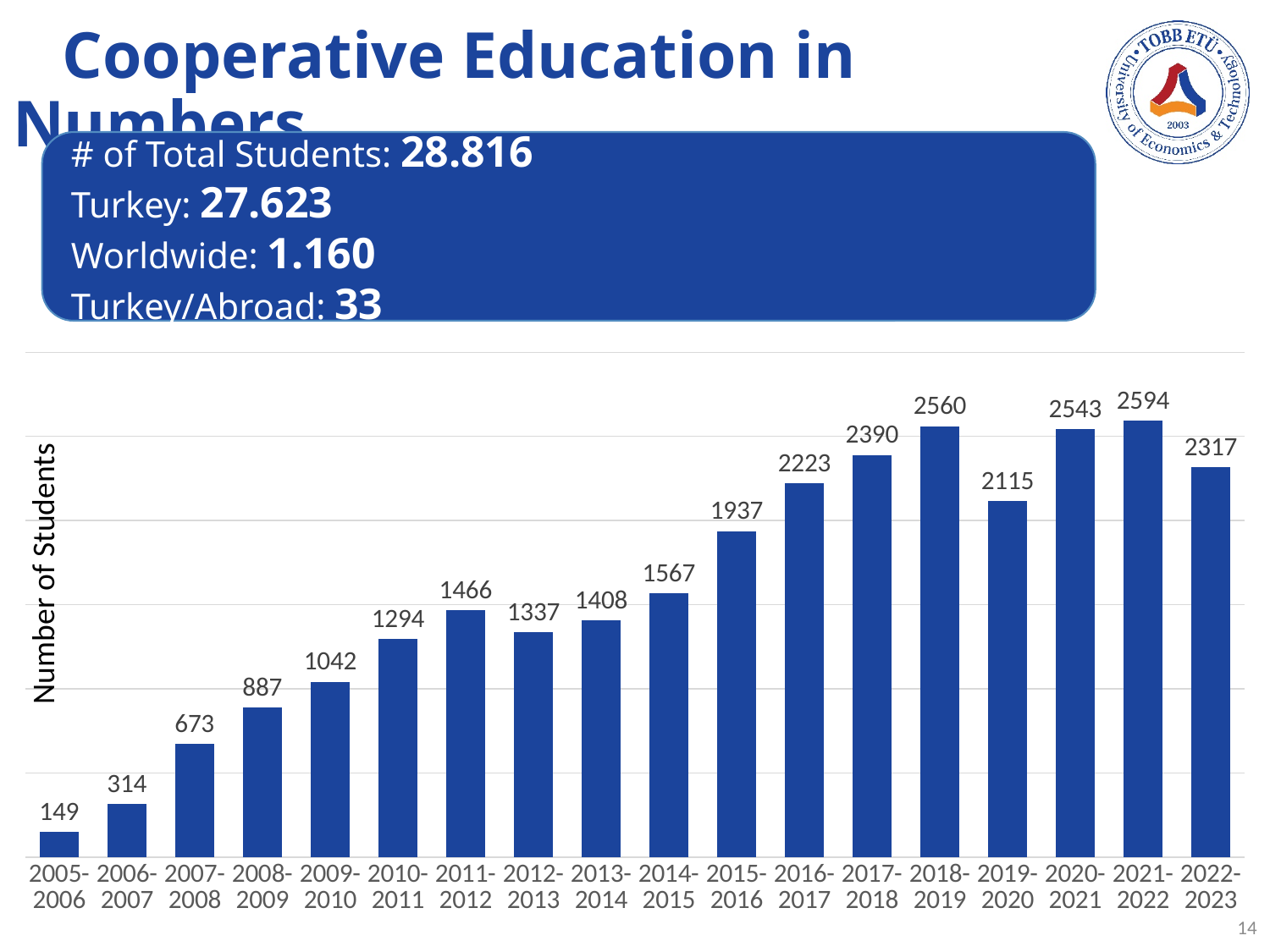
Which has more students, 2011-2012 or 2012-2013? 2011-2012 What is the number of students for 2022-2023? 2317 What is the difference in number of students between 2021-2022 and 2022-2023? 277 Which academic year has the lowest number of students? 2005-2006 How many academic years are shown on the x axis? 18 What is the difference in number of students between 2018-2019 and 2019-2020? 445 What is the number of students for 2005-2006? 149 What kind of chart is shown on the slide? Bar chart What is the number of students for 2015-2016? 1937 What is the label on the y axis of the chart? Number of Students Do the number of students generally rise or fall from 2005-2006 to 2018-2019? Rise Which academic year has the highest number of students? 2021-2022